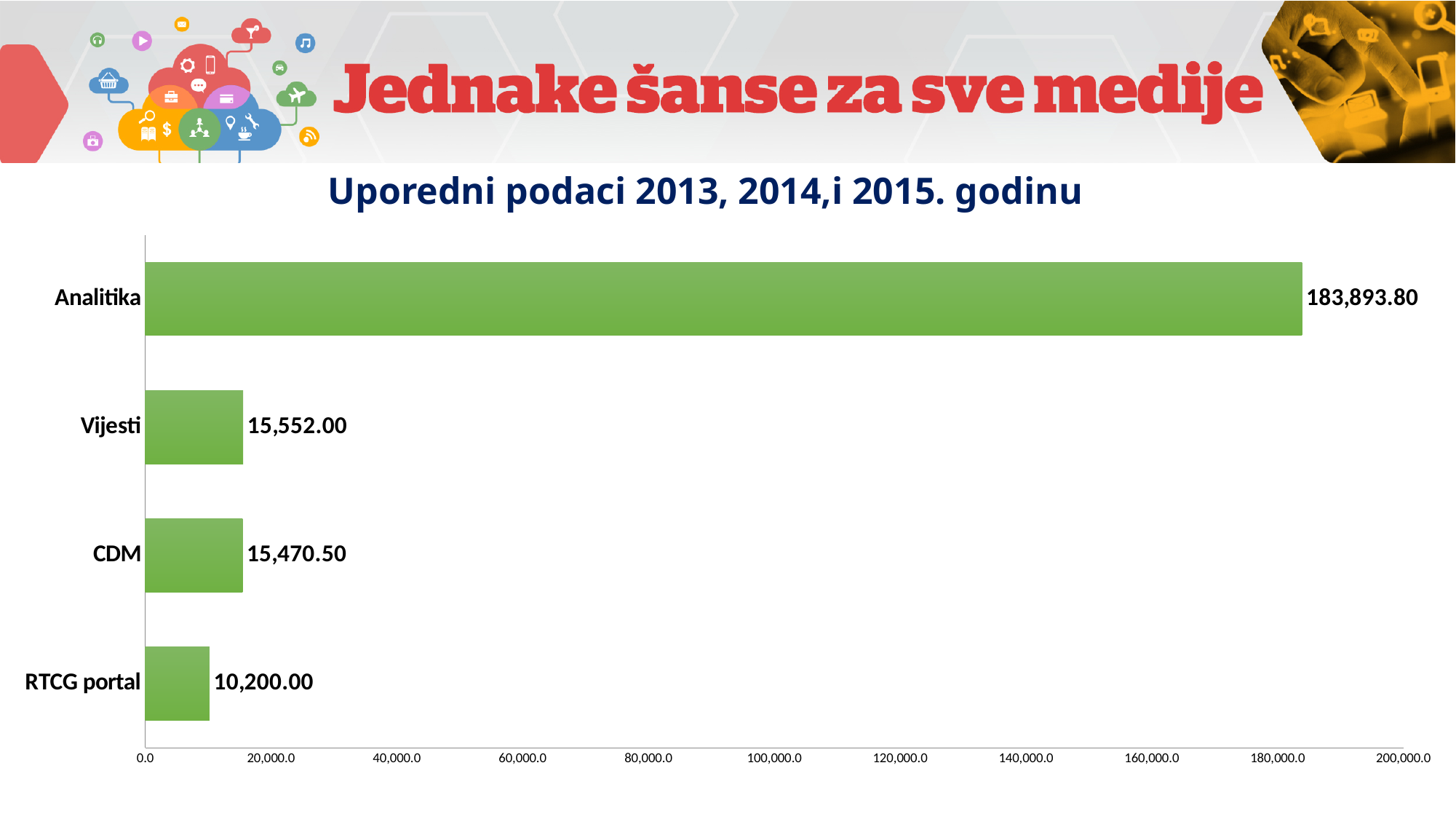
What is the value for Vijesti? 15,552.00 Which is larger, the value for Vijesti or the value for RTCG portal? Vijesti What is the value for Analitika? 183,893.80 What is the value for CDM? 15,470.50 Is the value for Analitika greater or less than 180,000.0? greater How many categories are shown in the chart? 4 What is the value for RTCG portal? 10,200.00 What is the difference between the values for Vijesti and CDM? 81.50 What is the difference between the values for Analitika and RTCG portal? 173,693.80 Which category has the lowest value? RTCG portal Which category has the highest value? Analitika What kind of chart is shown on the slide? Bar chart